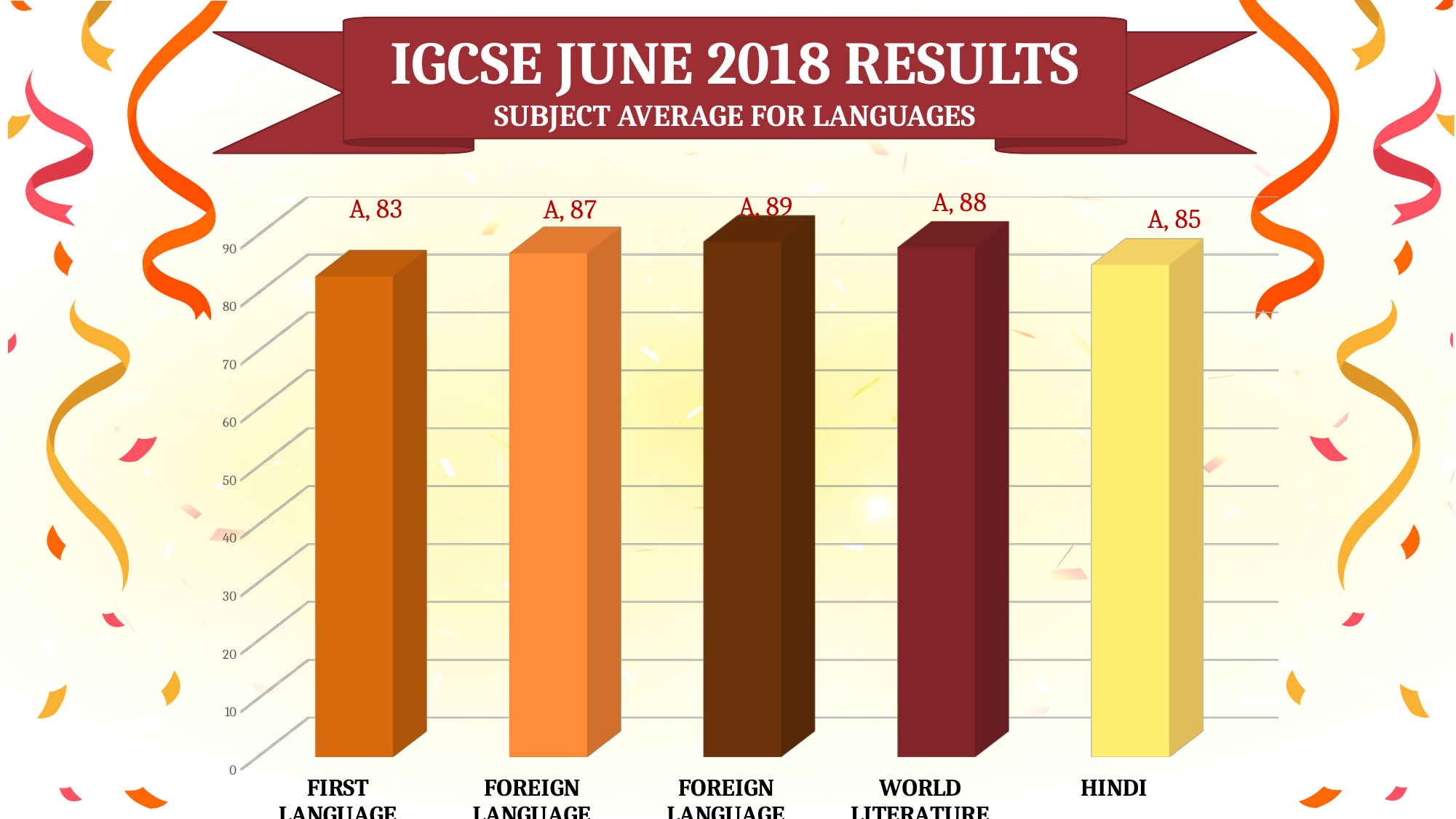
Which category has the lowest value? First Language What kind of chart is shown on the slide? bar chart Which bar has the highest value? the third bar from the left (Foreign Language, 89) What is the difference between the World Literature value and the Hindi value? 3 How many bars are plotted in the chart? 5 What is the subtitle of the chart shown on the banner? SUBJECT AVERAGE FOR LANGUAGES What is the data label shown above the Hindi bar? A, 85 What is the data label shown above the World Literature bar? A, 88 Which is larger, the value for Hindi or the value for First Language? Hindi What is the data label shown above the First Language bar? A, 83 What is the data label shown above the third bar from the left? A, 89 Is the value for Hindi greater or less than 80? greater